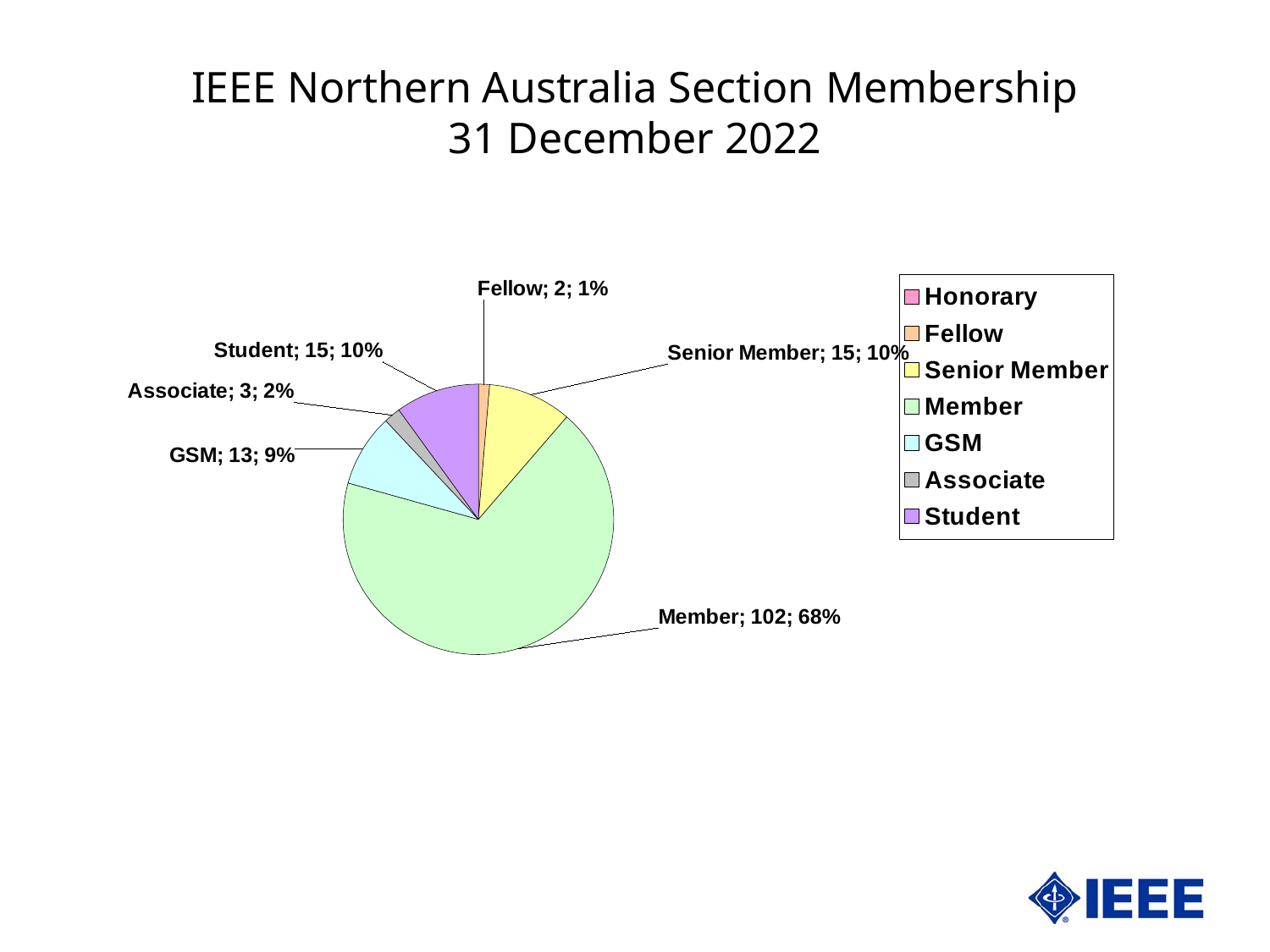
How many members are in the Member category? 102 What percentage of the membership is Senior Member? 10% What is the difference between the number of Member and Senior Member members? 87 Which is larger, the GSM count or the Student count? Student What kind of chart is shown on the slide? pie chart How many entries does the legend list? 7 What colour is the Member slice in the pie chart? light green Which category has the largest slice of the pie? Member What share of the pie does the Member slice represent? 68% Which labelled category has the smallest slice of the pie? Fellow How many members are in the GSM category? 13 What percentage of the membership is Associate? 2%